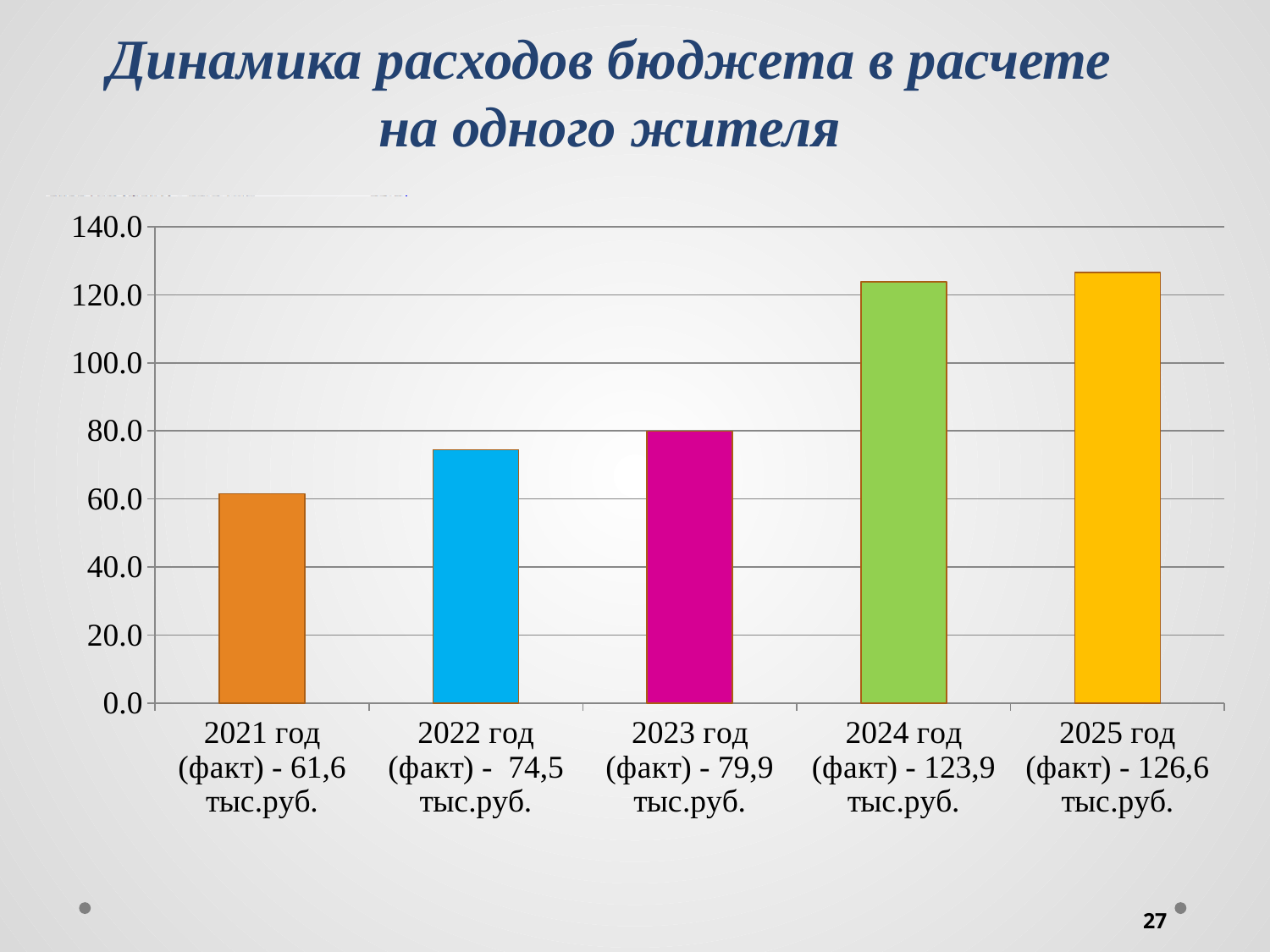
How many years are shown on the chart? 5 Do the values rise or fall from 2021 год to 2025 год? rise What is the value for 2021 год? 61,6 тыс.руб. Which year has the lowest value? 2021 год Which is larger, the value for 2023 год or the value for 2022 год? 2023 год What is the difference between the values for 2025 год and 2024 год? 2,7 тыс.руб. Is the value for 2024 год greater or less than 100.0? greater What is the value for 2023 год? 79,9 тыс.руб. What is the difference between the values for 2022 год and 2021 год? 12,9 тыс.руб. Which year has the highest value? 2025 год What kind of chart is shown on the slide? bar chart What is the value for 2024 год? 123,9 тыс.руб.